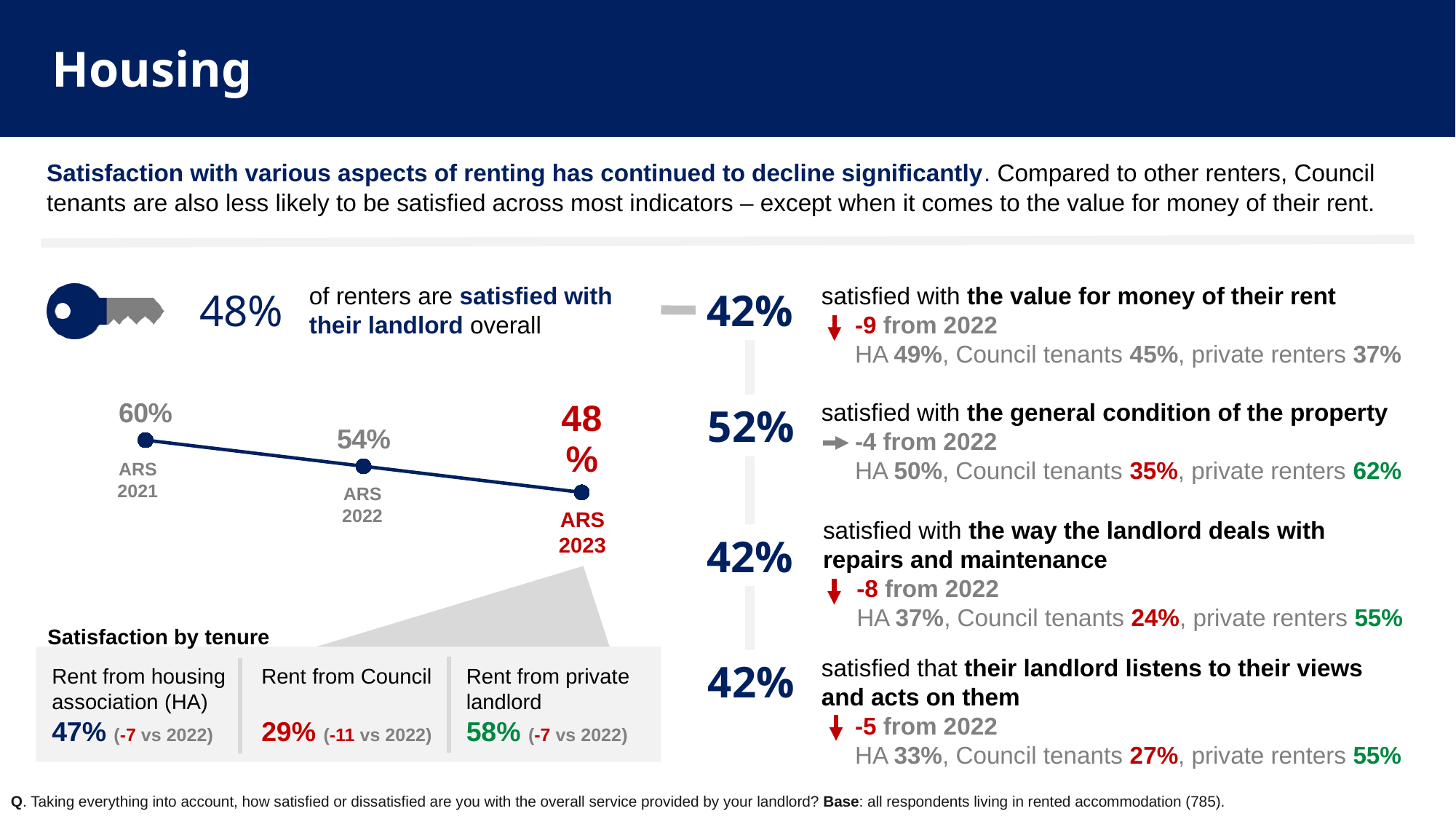
On the line chart on the left, what is the value for ARS 2023? 48% On the line chart on the left, which data point's label is shown in red? ARS 2023 On the line chart on the left, what is the difference between the ARS 2021 and ARS 2023 values? 12 percentage points On the line chart on the left, what is the value for ARS 2022? 54% On the line chart on the left, which is larger, the value for ARS 2021 or ARS 2022? ARS 2021 On the line chart on the left, which year has the highest value? ARS 2021 On the line chart on the left, what is the difference between the ARS 2022 and ARS 2023 values? 6 percentage points On the line chart on the left, do the values rise or fall from ARS 2021 to ARS 2023? Fall What kind of chart is shown on the left of the slide? Line chart On the line chart on the left, what is the value for ARS 2021? 60% How many data points are plotted on the line chart on the left? 3 On the line chart on the left, which year has the lowest value? ARS 2023